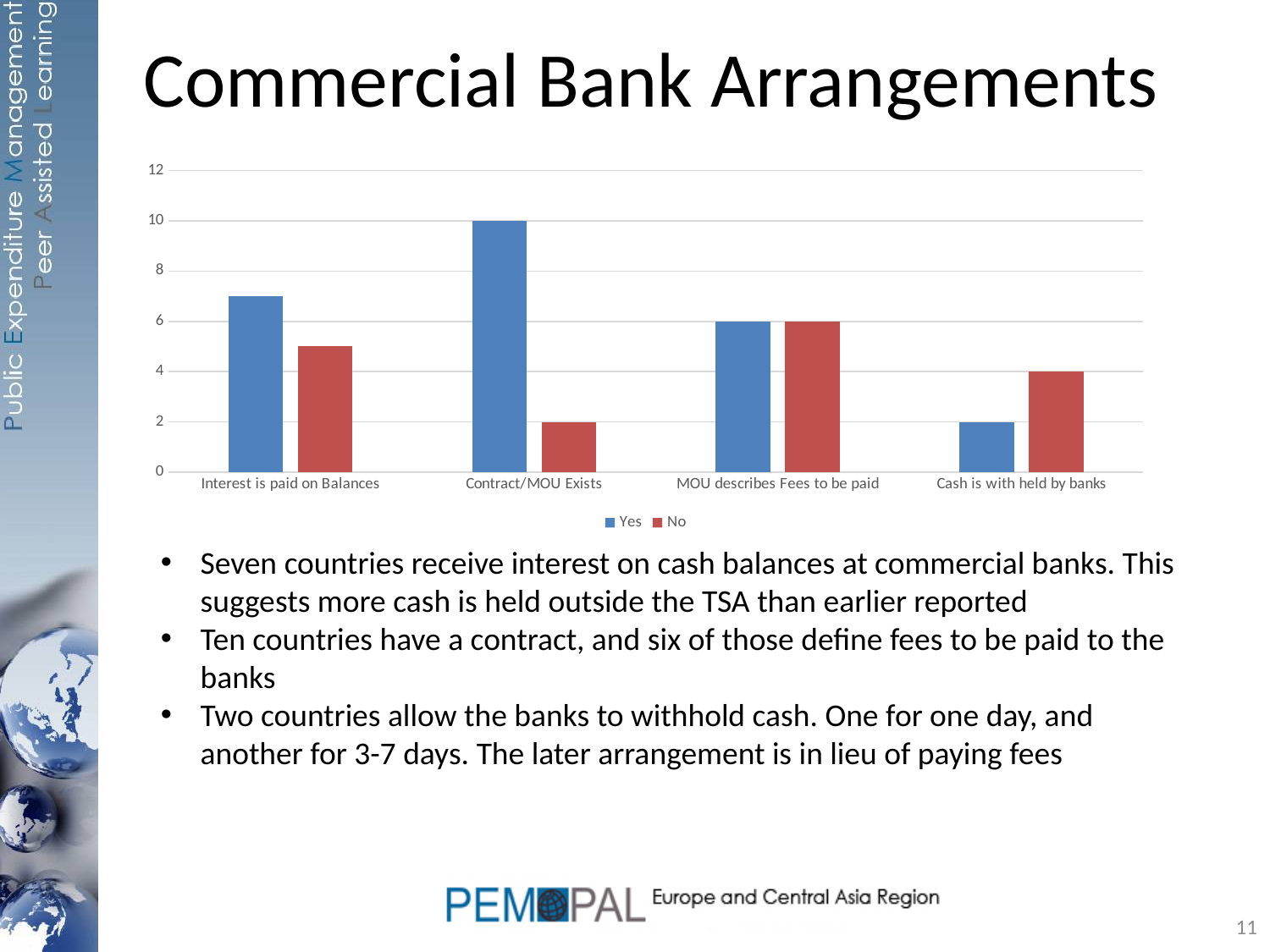
What is the value of the No bar for Cash is with held by banks? 4 What is the value of the Yes bar for MOU describes Fees to be paid? 6 Which category has the lowest Yes value? Cash is with held by banks How many series does the legend list? 2 For Cash is with held by banks, which is larger, the Yes bar or the No bar? No Is the Yes value for Interest is paid on Balances greater or less than 6? greater What type of chart is shown on the slide? Bar chart What is the difference between the Yes and No values for Contract/MOU Exists? 8 Which category has the highest Yes value? Contract/MOU Exists What is the value of the No bar for Contract/MOU Exists? 2 What is the value of the Yes bar for Contract/MOU Exists? 10 How many categories are shown on the x axis? 4